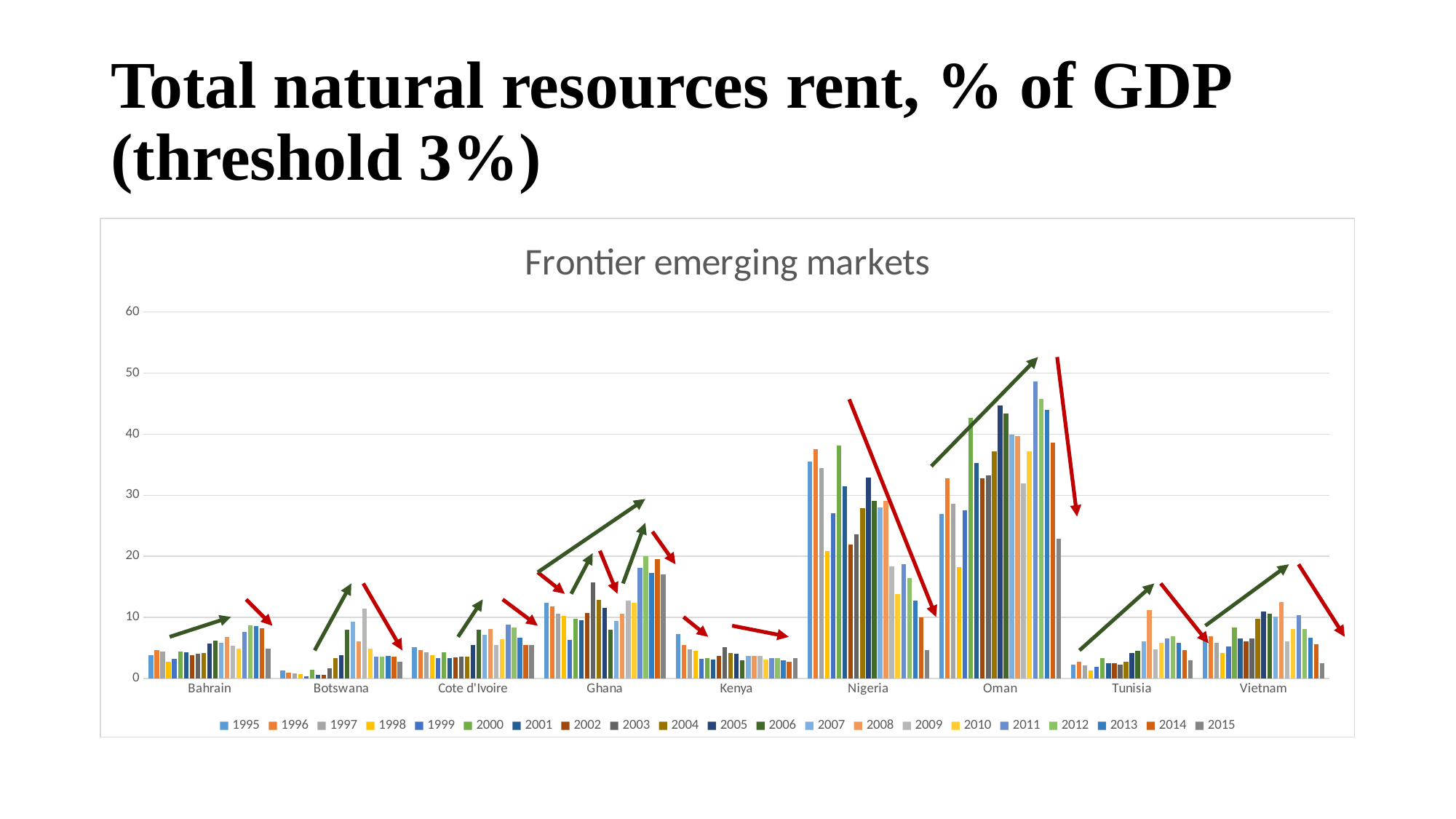
Is the value for Oman in 2011 greater or less than 40? greater Which country has the lowest bars overall in the chart? Botswana Which country has higher values in 1995, Nigeria or Kenya? Nigeria How many countries are shown on the x axis of the chart? 9 What is the title of the chart? Frontier emerging markets Which country has the tallest bar in the chart? Oman Is the value for Ghana in 2012 greater or less than 10? greater What is the highest value shown on the y axis of the chart? 60 What kind of chart is shown on the slide? bar chart Is the value for Nigeria in 1995 greater or less than 30? greater How many years (series) does the chart legend list? 21